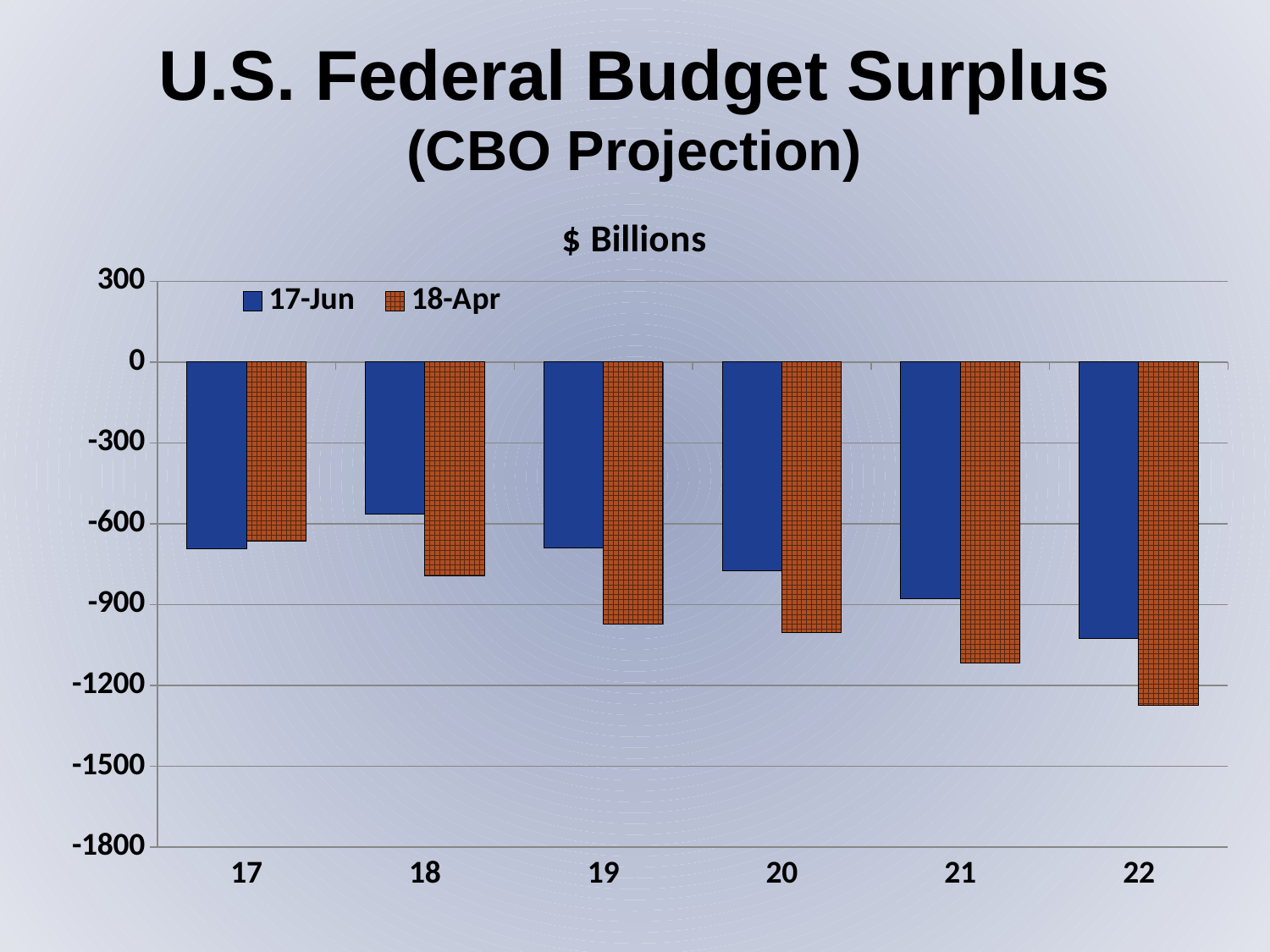
How many years (categories) are shown on the x axis? 6 For which year is the 17-Jun value highest (closest to zero)? 18 Do the 18-Apr values rise or fall from year 17 to year 22? fall What are the two series named in the legend? 17-Jun and 18-Apr Is the 17-Jun value for year 18 greater or less than -600? greater Is the 18-Apr value for year 22 greater or less than -1200? less What kind of chart is shown on the slide? bar chart What unit label is shown above the chart? $ Billions In year 19, which series has the larger (less negative) value, 17-Jun or 18-Apr? 17-Jun For which year is the 18-Apr value lowest (most negative)? 22 Is the 18-Apr value for year 19 greater or less than -900? less How many series does the legend list? 2